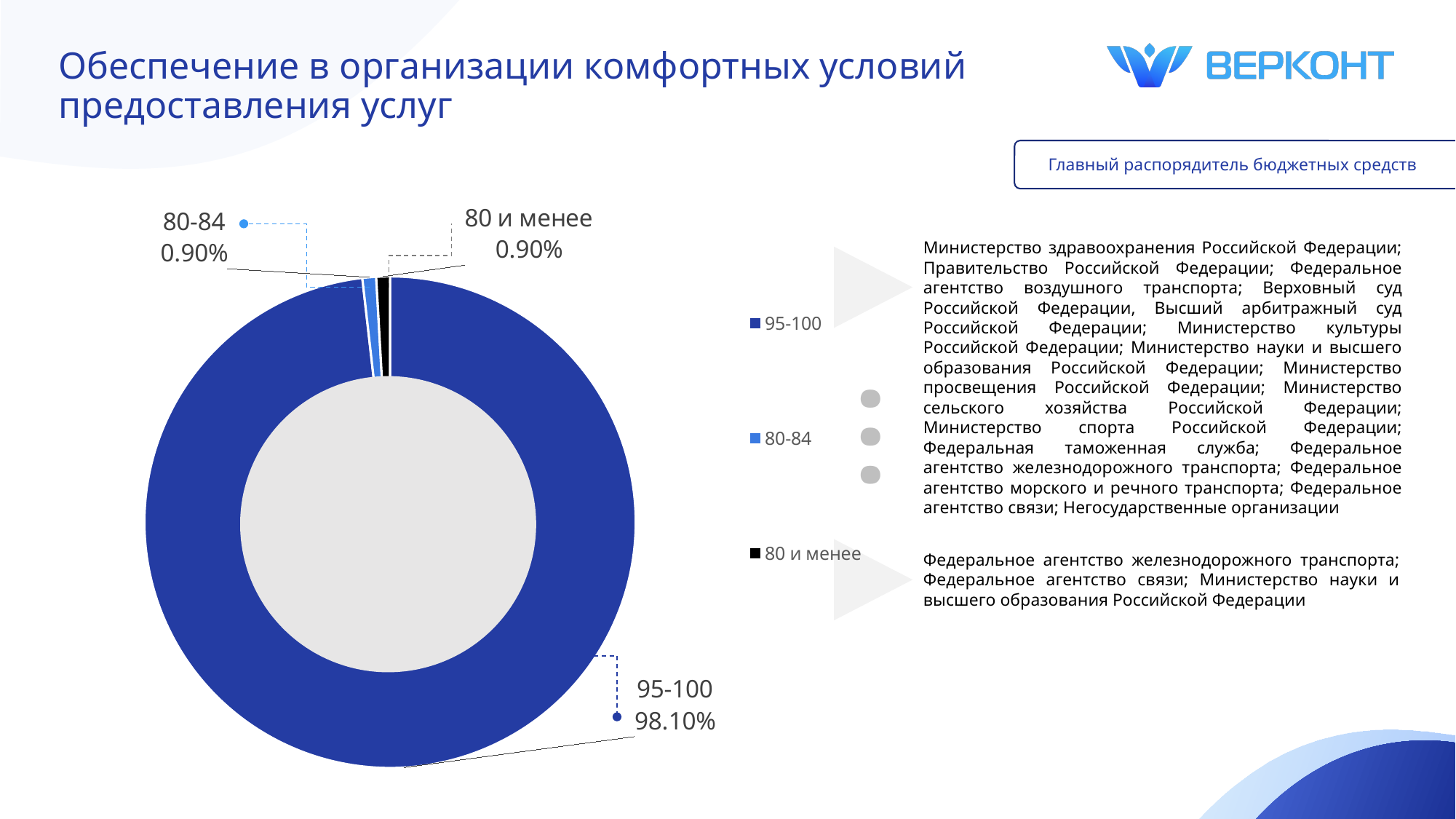
What share of the chart does the "80 и менее" category have? 0.90% What share of the chart does the "80-84" category have? 0.90% What is the combined share of the "80-84" and "80 и менее" categories? 1.80% How many categories (slices) does the chart have? 3 Which colour represents the "80 и менее" category in the chart? Black What kind of chart is shown on the slide? Doughnut (pie) chart What is the difference between the share of "95-100" and the share of "80-84"? 97.20% How many entries does the chart legend list? 3 What share of the chart does the "95-100" category have? 98.10% Which is larger: the share of "95-100" or the share of "80 и менее"? 95-100 Which category has the largest share of the chart? 95-100 Which colour represents the "95-100" category in the chart? Dark blue